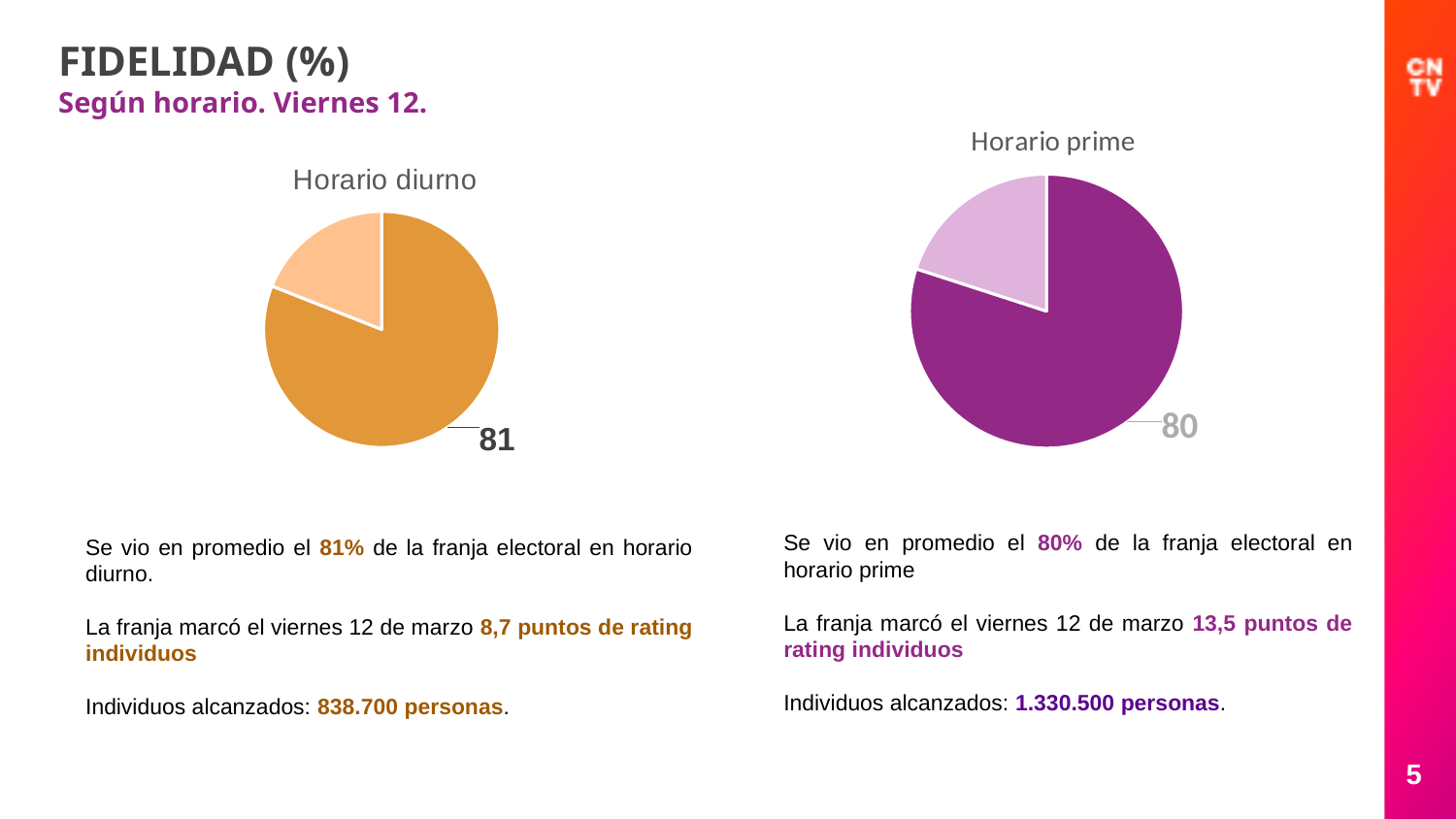
What is the title of the pie chart on the right of the slide? Horario prime In the "Horario diurno" chart, what value is printed on the large orange slice? 81 How many slices does the "Horario diurno" pie chart have? 2 In the "Horario diurno" chart, which slice is larger, the dark orange one or the light orange one? The dark orange one What kind of chart is the "Horario prime" chart? Pie chart Which chart has the larger labelled slice value, "Horario diurno" or "Horario prime"? Horario diurno What kind of chart is the "Horario diurno" chart? Pie chart What is the difference between the labelled value in the "Horario diurno" chart and the labelled value in the "Horario prime" chart? 1 In the "Horario prime" chart, which slice is smaller, the dark purple one or the light pink one? The light pink one In the "Horario prime" chart, what value is printed on the large purple slice? 80 What is the title of the pie chart on the left of the slide? Horario diurno How many slices does the "Horario prime" pie chart have? 2